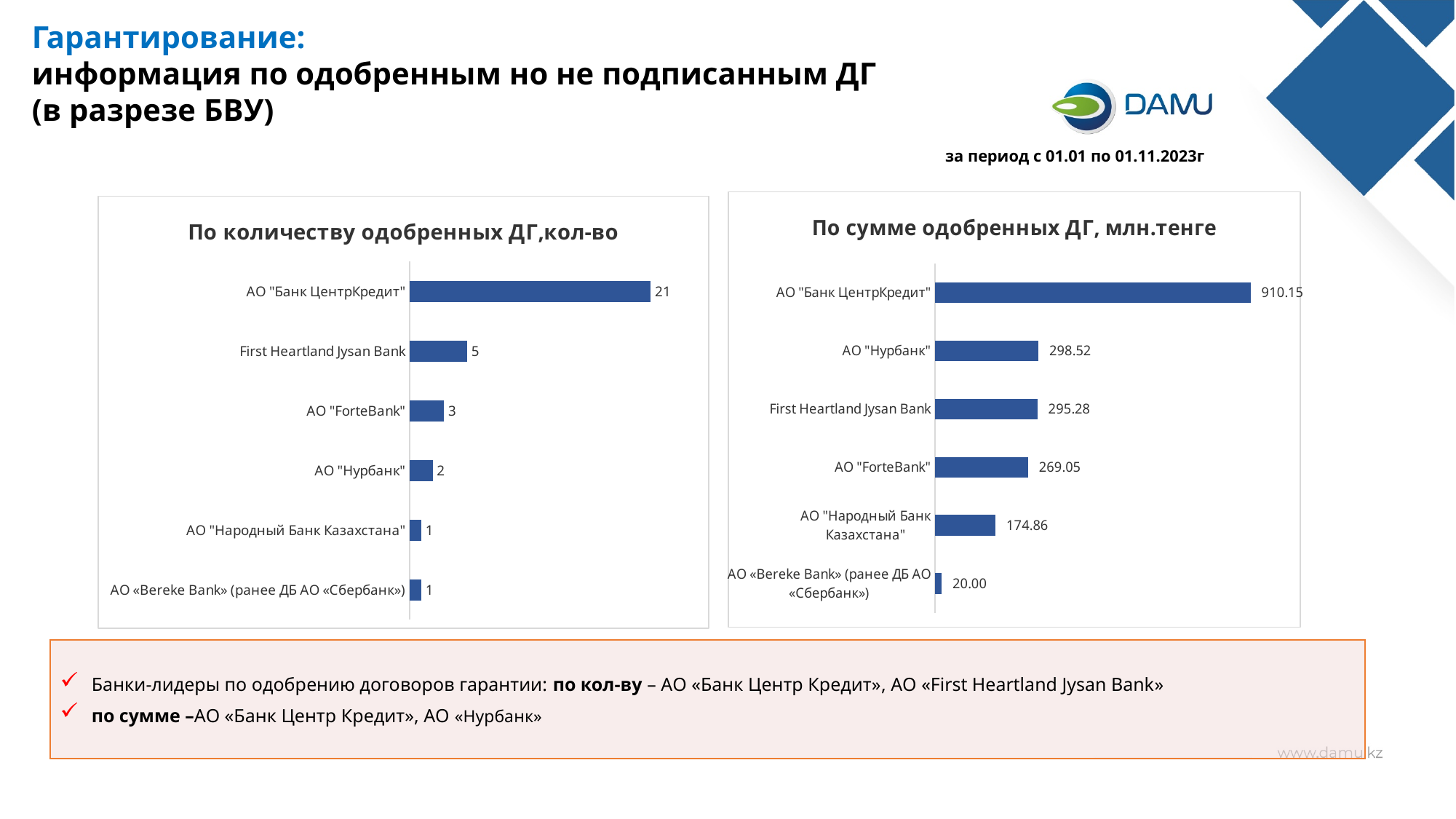
What type of chart is "По количеству одобренных ДГ,кол-во"? Bar chart In the chart "По сумме одобренных ДГ, млн.тенге", what is the difference between АО "Нурбанк" and First Heartland Jysan Bank? 3.24 In the chart "По количеству одобренных ДГ,кол-во", what is the difference between АО "Банк ЦентрКредит" and First Heartland Jysan Bank? 16 What is the title of the chart on the right side of the slide? По сумме одобренных ДГ, млн.тенге In the chart "По количеству одобренных ДГ,кол-во", which is larger: АО "ForteBank" or АО "Нурбанк"? АО "ForteBank" In the chart "По сумме одобренных ДГ, млн.тенге", which bank has the highest value? АО "Банк ЦентрКредит" In the chart "По сумме одобренных ДГ, млн.тенге", which bank has the lowest value? АО «Bereke Bank» (ранее ДБ АО «Сбербанк») In the chart "По количеству одобренных ДГ,кол-во", what is the value for АО "Банк ЦентрКредит"? 21 How many banks are shown in the chart "По сумме одобренных ДГ, млн.тенге"? 6 In the chart "По сумме одобренных ДГ, млн.тенге", what is the value for АО «Bereke Bank» (ранее ДБ АО «Сбербанк»)? 20.00 In the chart "По количеству одобренных ДГ,кол-во", what is the value for First Heartland Jysan Bank? 5 In the chart "По сумме одобренных ДГ, млн.тенге", what is the value for АО "Нурбанк"? 298.52